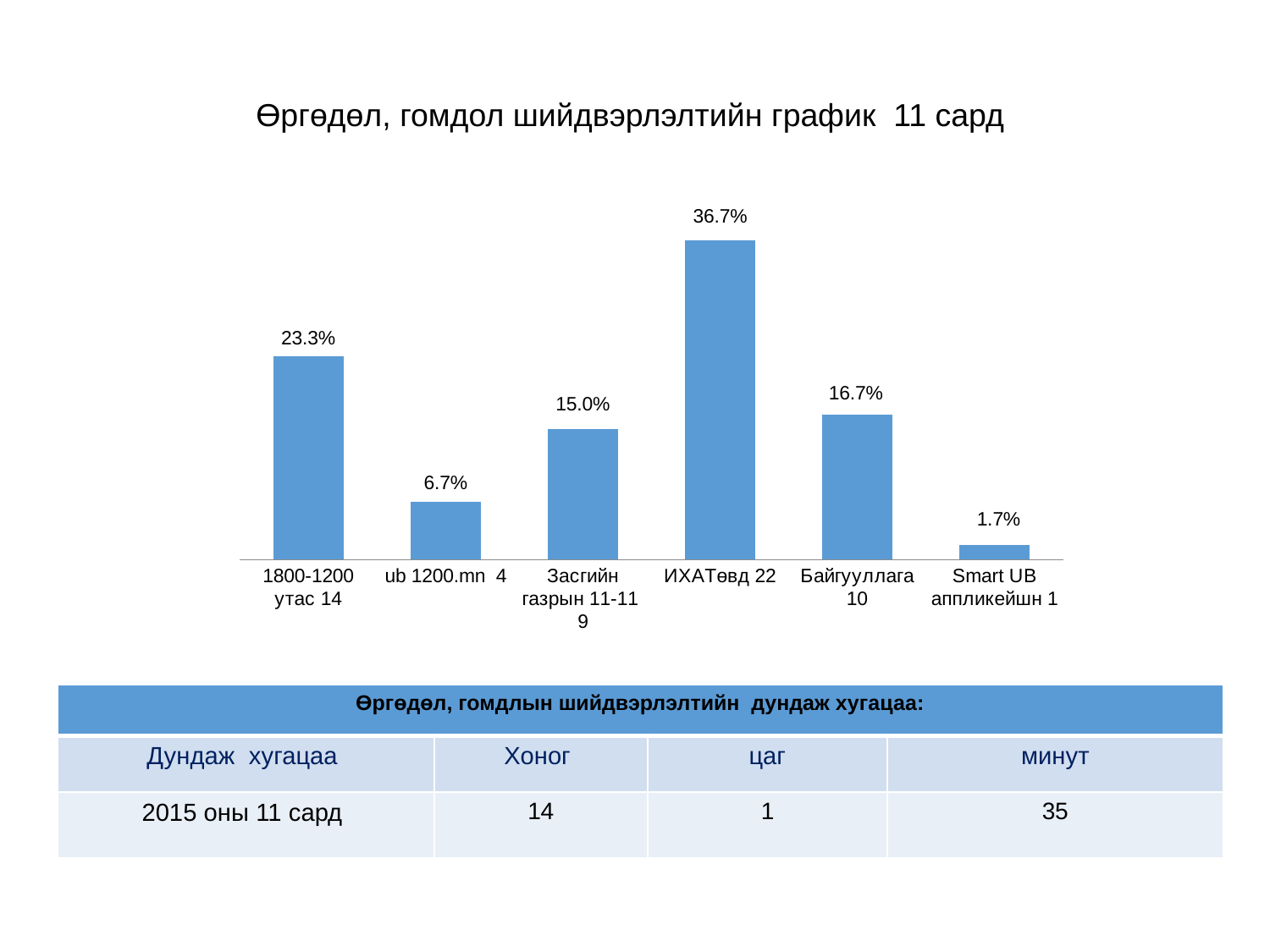
What is the title of the chart? Өргөдөл, гомдол шийдвэрлэлтийн график 11 сард What is the value for "Байгууллага 10"? 16.7% What is the difference between the values for "ИХАТөвд 22" and "1800-1200 утас 14"? 13.4% Which category has the highest value? ИХАТөвд 22 What is the value for "Smart UB аппликейшн 1"? 1.7% What is the value for "ИХАТөвд 22"? 36.7% Which category has the lowest value? Smart UB аппликейшн 1 What kind of chart is shown on the slide? bar chart What is the difference between the values for "Байгууллага 10" and "Засгийн газрын 11-11 9"? 1.7% How many categories are shown in the chart? 6 Which is larger, the value for "ub 1200.mn 4" or the value for "Засгийн газрын 11-11 9"? Засгийн газрын 11-11 9 What is the value for "1800-1200 утас 14"? 23.3%